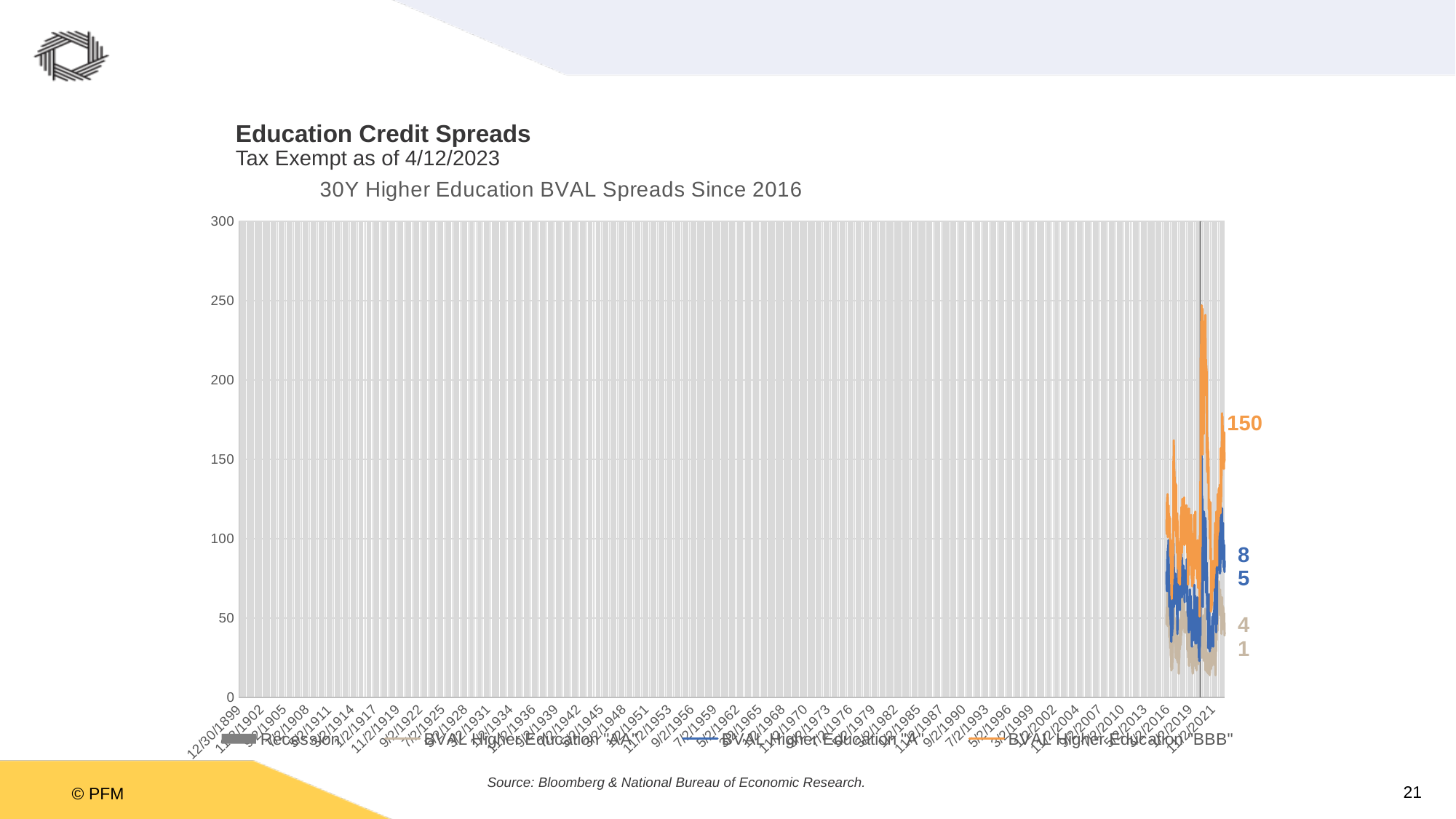
What is the latest labelled value for the BVAL Higher Education "A" series? 85 What is the highest value shown on the chart's vertical axis? 300 Which series has the lowest value at the right end of the chart? BVAL Higher Education "AA" At the right end of the chart, which is larger: the "A" series or the "AA" series? BVAL Higher Education "A" Which series has the highest value at the right end of the chart? BVAL Higher Education "BBB" What is the latest labelled value for the BVAL Higher Education "AA" series? 41 How many entries does the chart legend list? 4 Is the peak value of the BVAL Higher Education "BBB" series greater or less than 200? greater What is the latest labelled value for the BVAL Higher Education "BBB" series? 150 What type of chart is shown on the slide? line chart What is the title of the chart? 30Y Higher Education BVAL Spreads Since 2016 What is the difference between the latest labelled values of the "BBB" series and the "A" series? 65